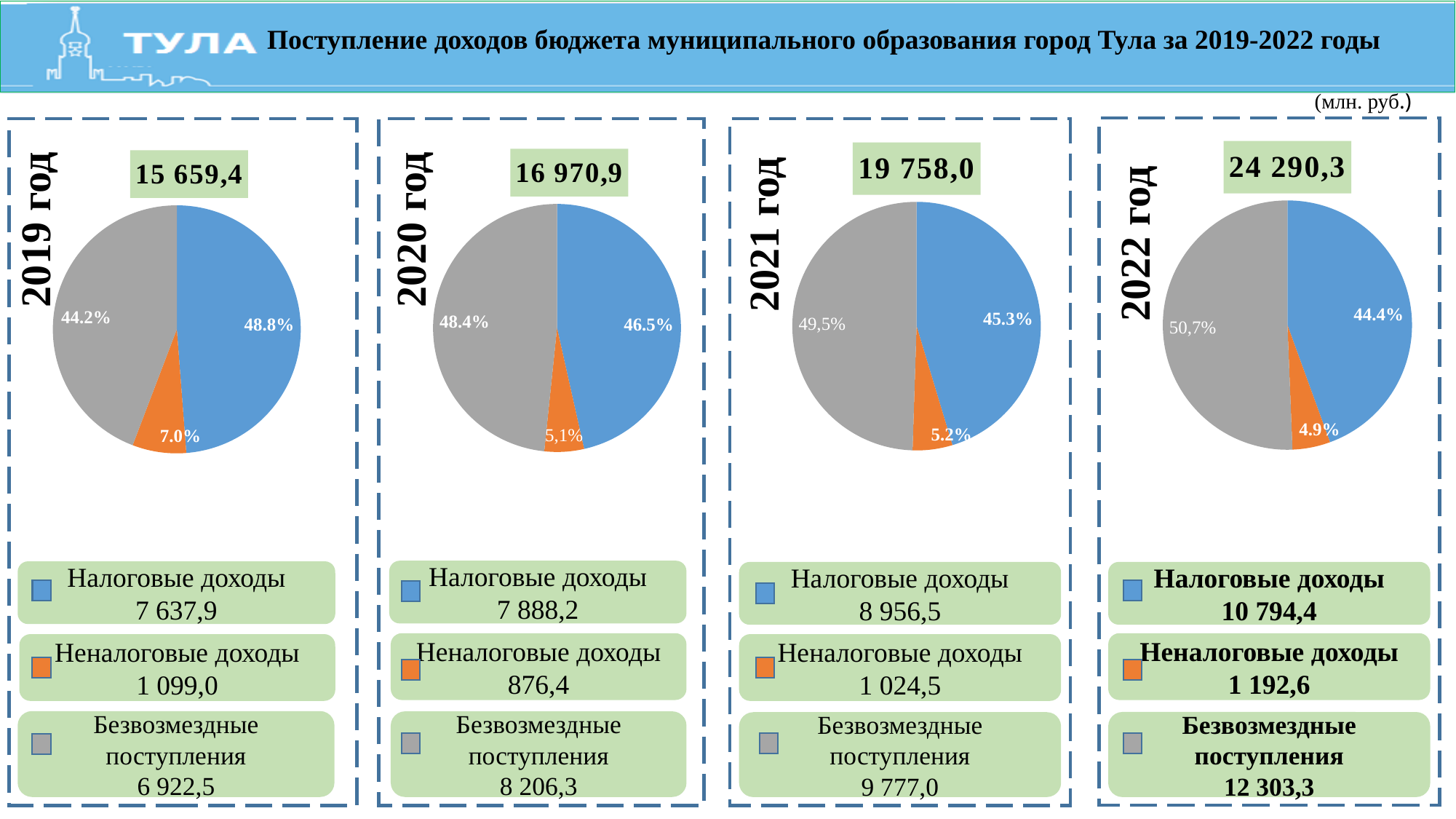
How many slices does the 2020 год pie chart have? 3 What type of chart is used for each year on the slide? Pie chart In the 2021 год chart, what is the value shown for Безвозмездные поступления in the legend? 9 777,0 In the 2021 год pie chart, which category has the largest slice? Безвозмездные поступления In the 2019 год pie chart, which category has the smallest slice? Неналоговые доходы In the 2022 год chart, what total is shown above the pie? 24 290,3 In the 2022 год pie chart, what share of the pie is Безвозмездные поступления? 50,7% In the 2022 год chart, what is the difference between the legend values for Безвозмездные поступления and Налоговые доходы? 1 508,9 Across the four charts from 2019 to 2022, does the share of Неналоговые доходы rise or fall? Fall In the 2020 год chart, what is the value shown for Неналоговые доходы in the legend? 876,4 In the 2019 год pie chart, what share of the pie is Налоговые доходы? 48.8% In the 2020 год pie chart, which is larger: Налоговые доходы or Безвозмездные поступления? Безвозмездные поступления